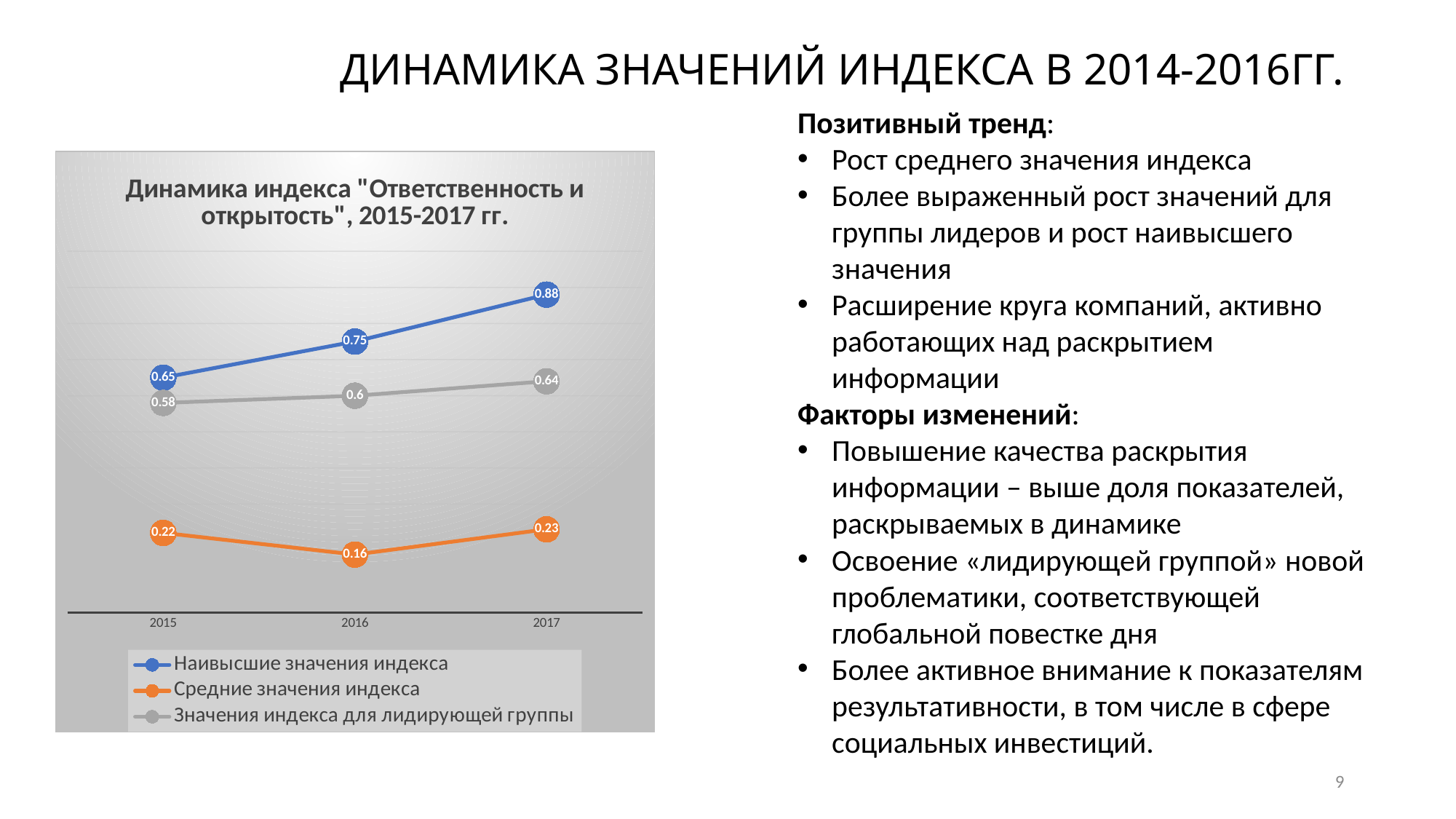
What is the value of "Значения индекса для лидирующей группы" in 2015? 0.58 What is the value of "Наивысшие значения индекса" in 2017? 0.88 Which is larger in 2016: "Наивысшие значения индекса" or "Значения индекса для лидирующей группы"? Наивысшие значения индекса How many years are shown on the x axis? 3 What is the value of "Наивысшие значения индекса" in 2015? 0.65 What is the value of "Средние значения индекса" in 2016? 0.16 Does "Наивысшие значения индекса" rise or fall from 2015 to 2017? Rise In which year is "Наивысшие значения индекса" highest? 2017 What type of chart is shown on the slide? Line chart How many series does the legend list? 3 In which year is "Средние значения индекса" lowest? 2016 What is the difference between "Наивысшие значения индекса" in 2017 and in 2015? 0.23